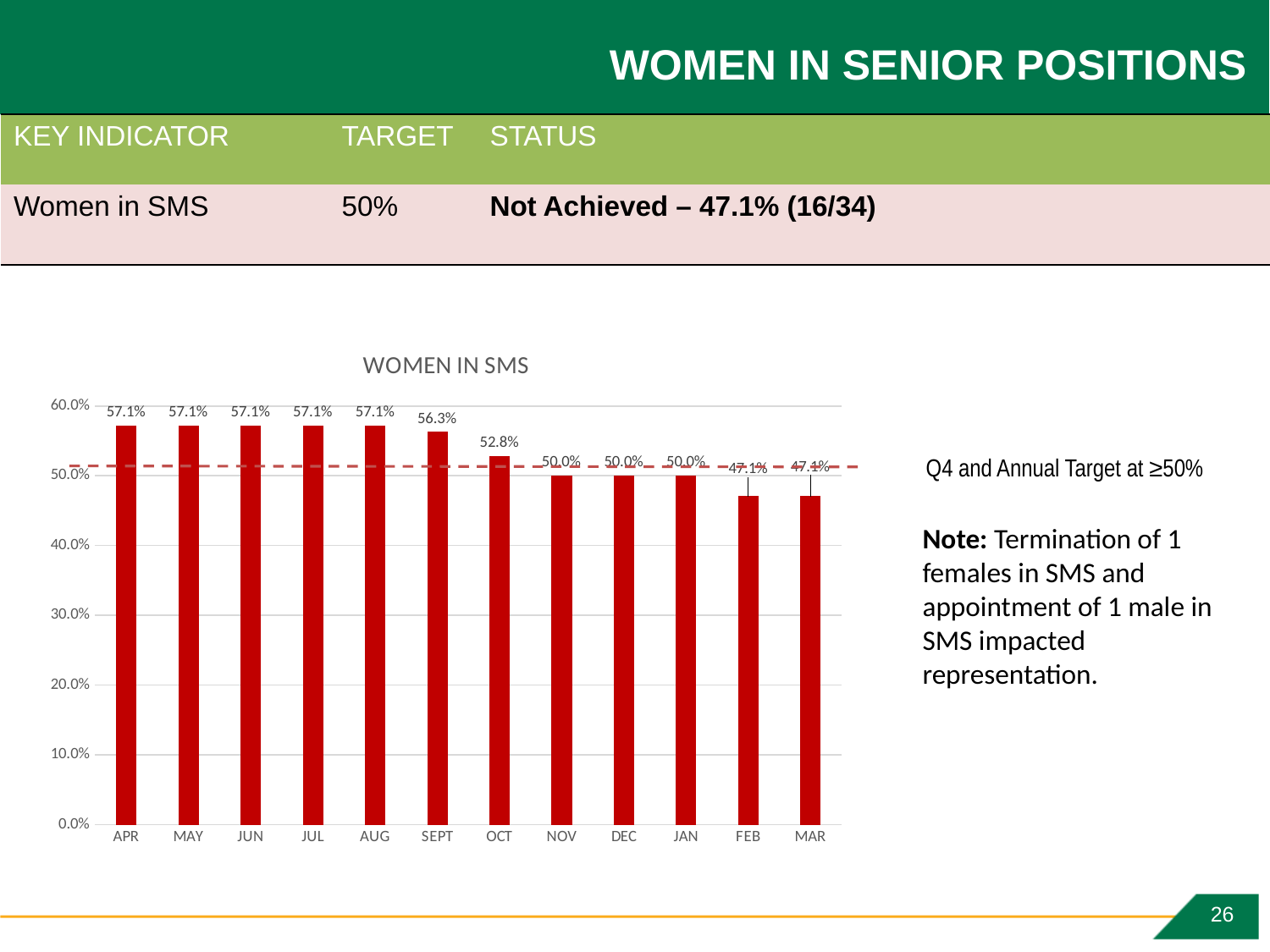
What is the difference between the SEPT value and the OCT value in the WOMEN IN SMS chart? 3.5% What is the value for OCT in the WOMEN IN SMS chart? 52.8% Which month has the lowest value in the WOMEN IN SMS chart? FEB and MAR (47.1%) What kind of chart is the WOMEN IN SMS chart? bar chart Is the value for FEB in the WOMEN IN SMS chart greater or less than 50.0%? less What is the difference between the APR value and the MAR value in the WOMEN IN SMS chart? 10.0% Which is larger in the WOMEN IN SMS chart, the value for OCT or the value for NOV? OCT What is the value for DEC in the WOMEN IN SMS chart? 50.0% What is the value for MAR in the WOMEN IN SMS chart? 47.1% Do the values in the WOMEN IN SMS chart rise or fall from APR to MAR? fall What is the value for SEPT in the WOMEN IN SMS chart? 56.3% How many months are shown on the x axis of the WOMEN IN SMS chart? 12